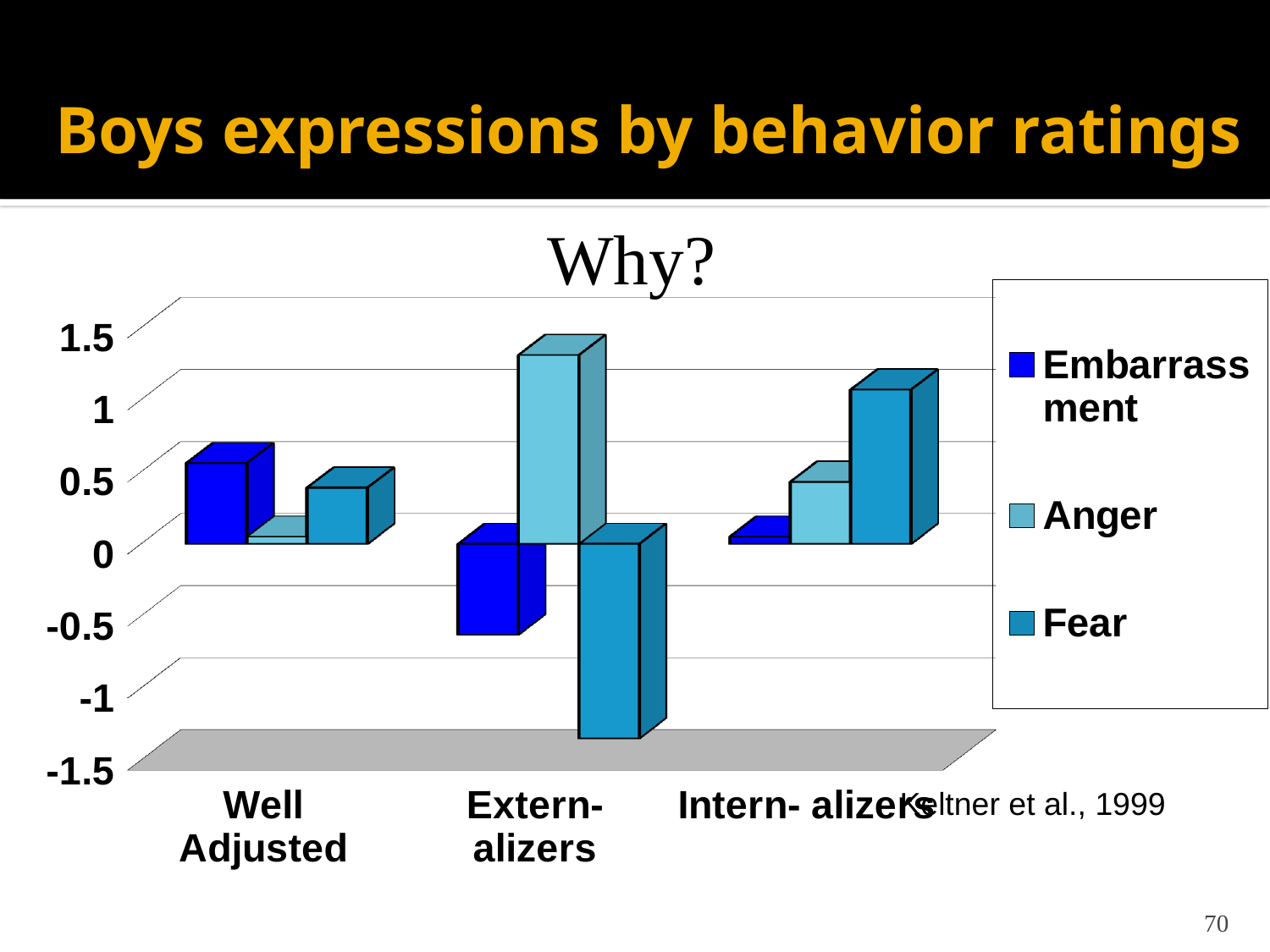
Which category has the highest Fear value? Internalizers Which category has the lowest Embarrassment value? Externalizers Is the Fear value for Externalizers greater or less than -1? less Which category has the lowest Fear value? Externalizers How many categories are shown on the x axis? 3 What is the title shown above the chart? Why? Is the Anger value for Externalizers greater or less than 1? greater What kind of chart is shown on the slide? bar chart Which category has the highest Anger value? Externalizers How many series does the legend list? 3 Is the Embarrassment value for Externalizers greater or less than 0? less For Well Adjusted, which is larger: the Embarrassment value or the Fear value? Embarrassment